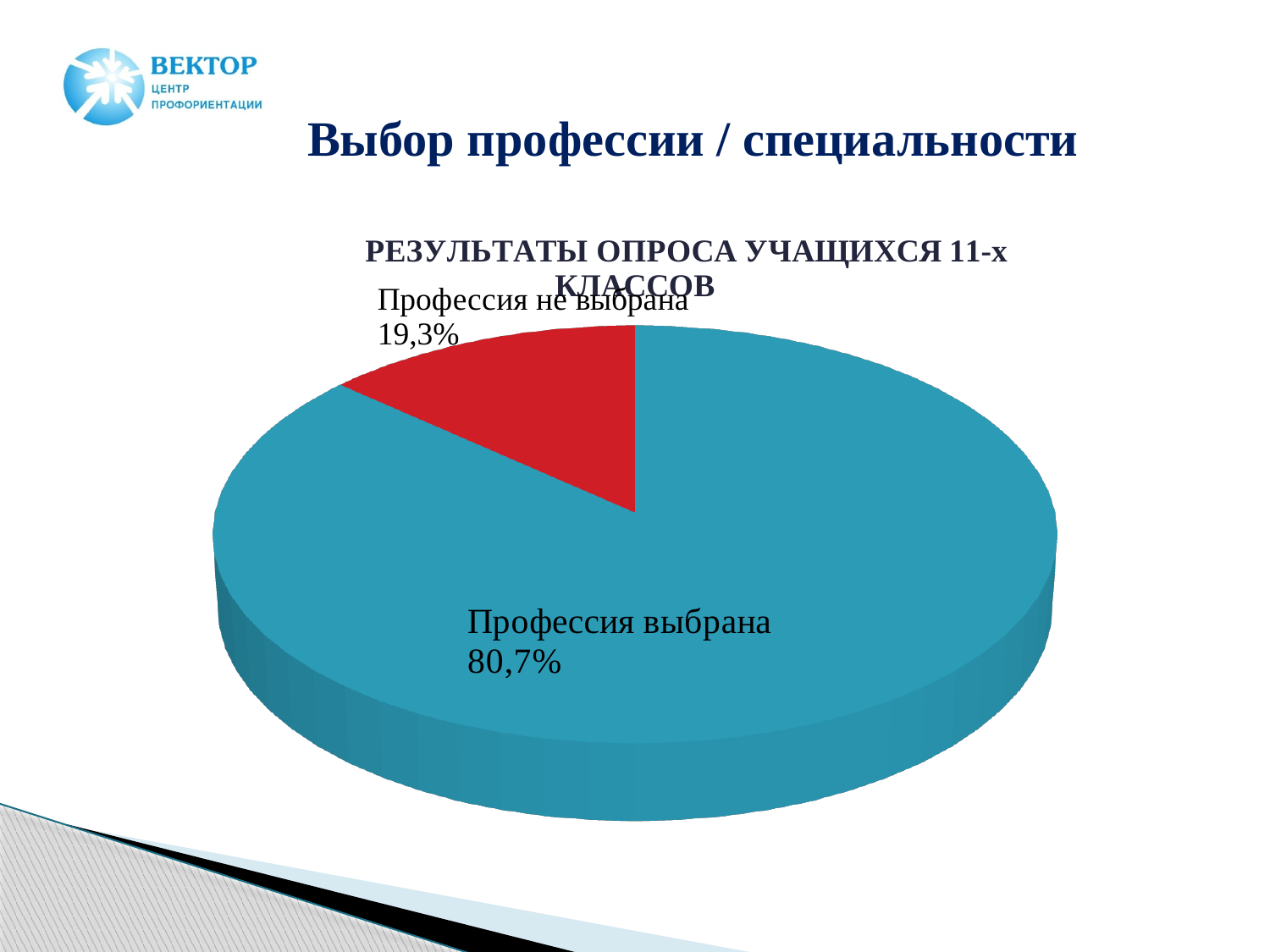
What percentage of students have chosen a profession (Профессия выбрана)? 80,7% Which category has the smallest share of the pie? Профессия не выбрана What is the difference in percentage points between 'Профессия выбрана' and 'Профессия не выбрана'? 61,4 How many categories are shown in the pie chart? 2 What percentage of students have not chosen a profession (Профессия не выбрана)? 19,3% Which category has the largest share of the pie? Профессия выбрана What kind of chart is shown on the slide? Pie chart Which is larger: the share for 'Профессия выбрана' or for 'Профессия не выбрана'? Профессия выбрана What colour is the slice for 'Профессия не выбрана'? Red What is the title of the chart? РЕЗУЛЬТАТЫ ОПРОСА УЧАЩИХСЯ 11-х КЛАССОВ What is the share of the pie taken by 'Профессия не выбрана'? 19,3%